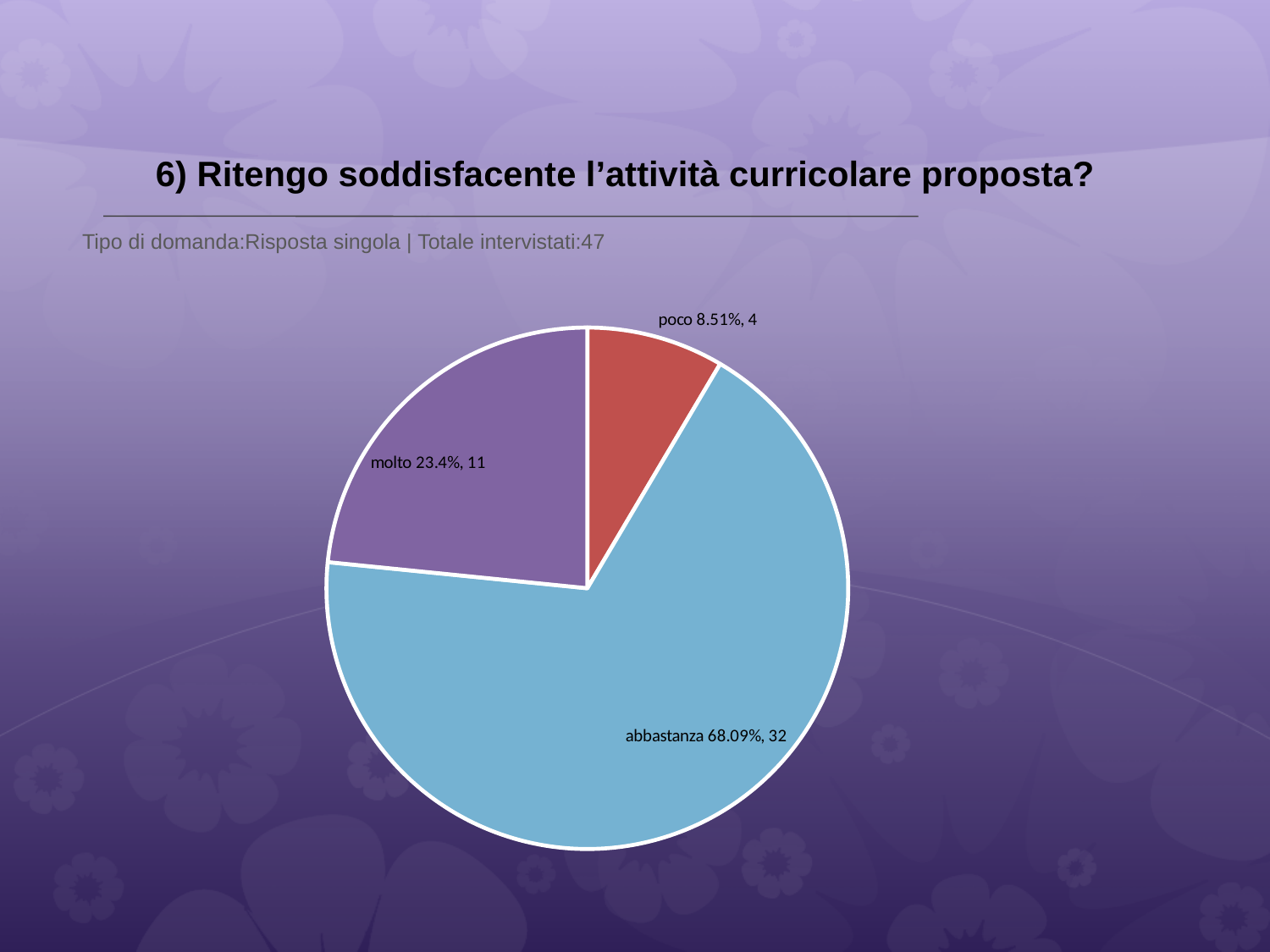
What is the count for the 'poco' slice? 4 What is the count for the 'abbastanza' slice? 32 What share of the pie does the 'abbastanza' slice represent? 68.09% How many slices does the pie chart have? 3 What kind of chart is shown on the slide? pie chart What is the difference in count between 'abbastanza' and 'molto'? 21 What share of the pie does the 'molto' slice represent? 23.4% What share of the pie does the 'poco' slice represent? 8.51% Which category has the largest slice? abbastanza Which is larger, the 'molto' slice or the 'poco' slice? molto Which category has the smallest slice? poco What is the count for the 'molto' slice? 11